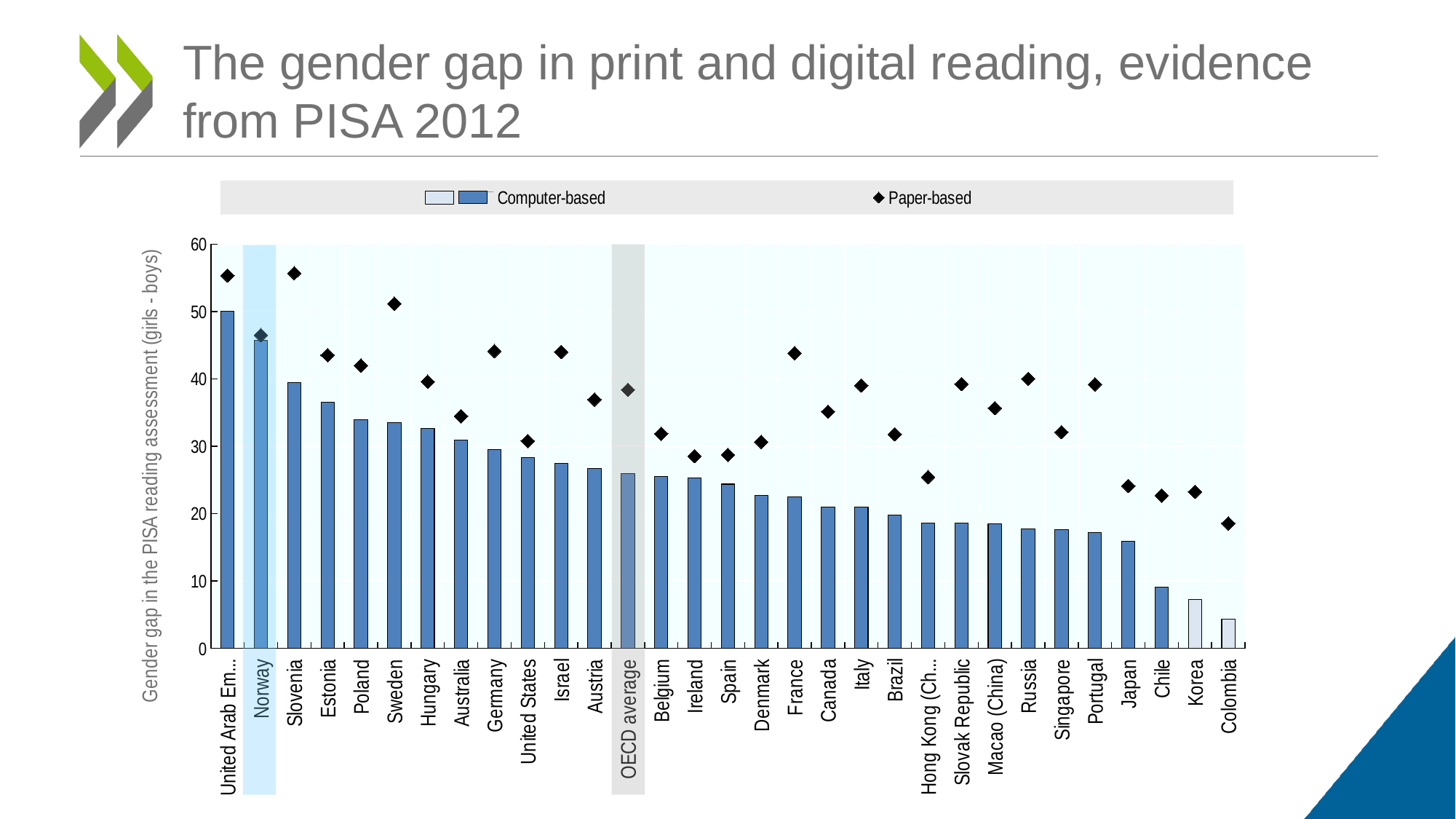
Which category has the lowest Computer-based bar? Colombia Which category has the highest Computer-based bar? United Arab Em... Is the Paper-based value for Sweden greater or less than 50? greater Do the Computer-based bars rise or fall from left to right along the x axis? fall Which is larger, the Computer-based value for Norway or for Slovenia? Norway Which category has the lowest Paper-based value? Colombia What kind of chart is shown on the slide? bar chart How many categories are shown along the x axis? 31 Is the Computer-based value for Norway greater or less than 40? greater Is the Computer-based value for Chile greater or less than 10? less What are the two series named in the legend? Computer-based and Paper-based How many series does the legend list? 2